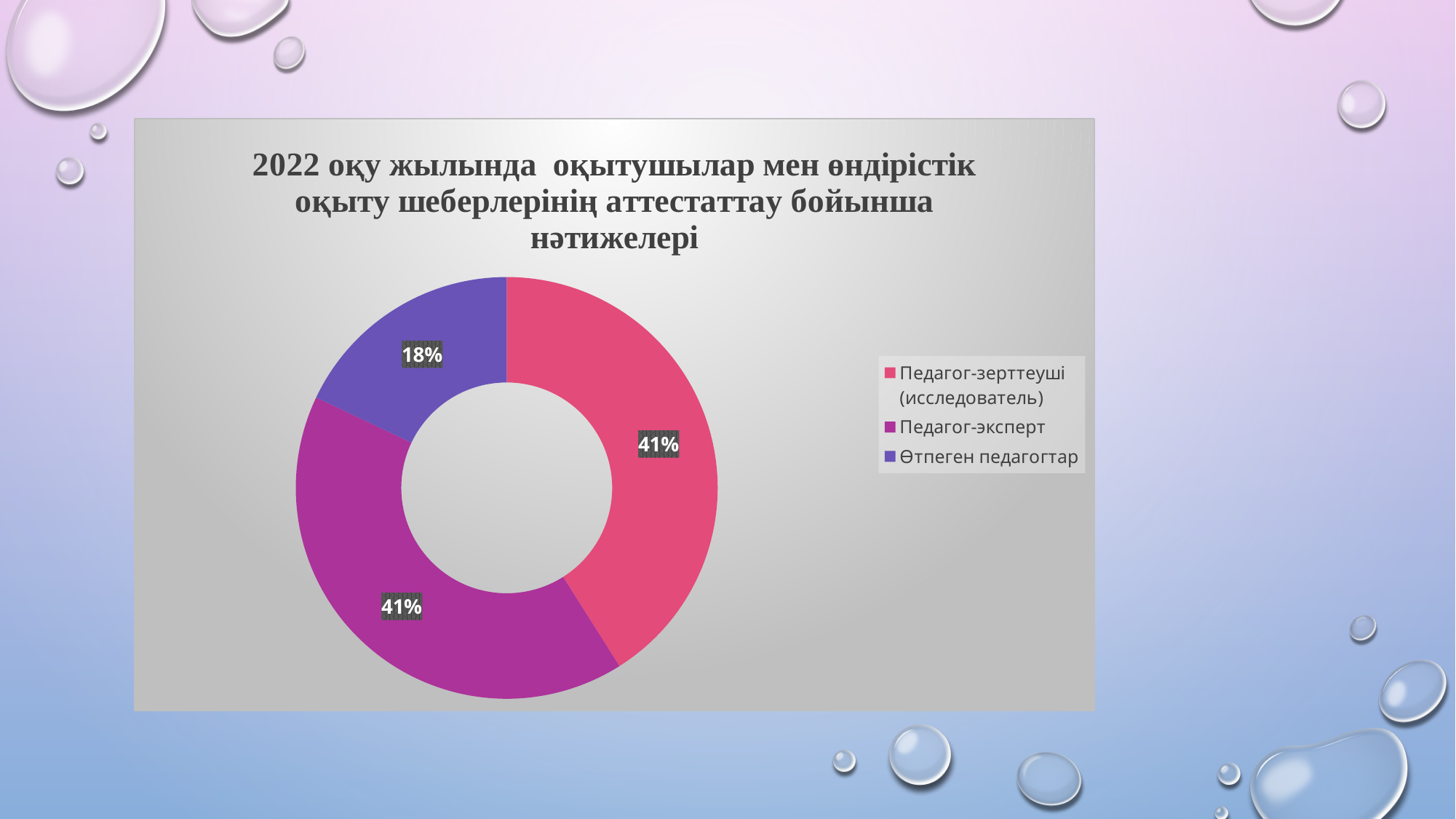
What share of the chart does Өтпеген педагогтар represent? 18% How many categories are shown in the chart? 3 What kind of chart is shown on the slide? Doughnut (pie) chart Which category has the smallest share of the chart? Өтпеген педагогтар Which is larger, the share for Педагог-эксперт or the share for Өтпеген педагогтар? Педагог-эксперт What percentage is shown for Педагог-зерттеуші (исследователь)? 41% By how many percentage points does Педагог-зерттеуші (исследователь) exceed Өтпеген педагогтар? 23 percentage points Do Педагог-зерттеуші (исследователь) and Педагог-эксперт have the same share? Yes, both 41% What percentage is shown for Өтпеген педагогтар? 18% Which colour represents Өтпеген педагогтар in the chart? Purple (blue-violet) How many entries does the legend list? 3 What percentage is shown for Педагог-эксперт? 41%